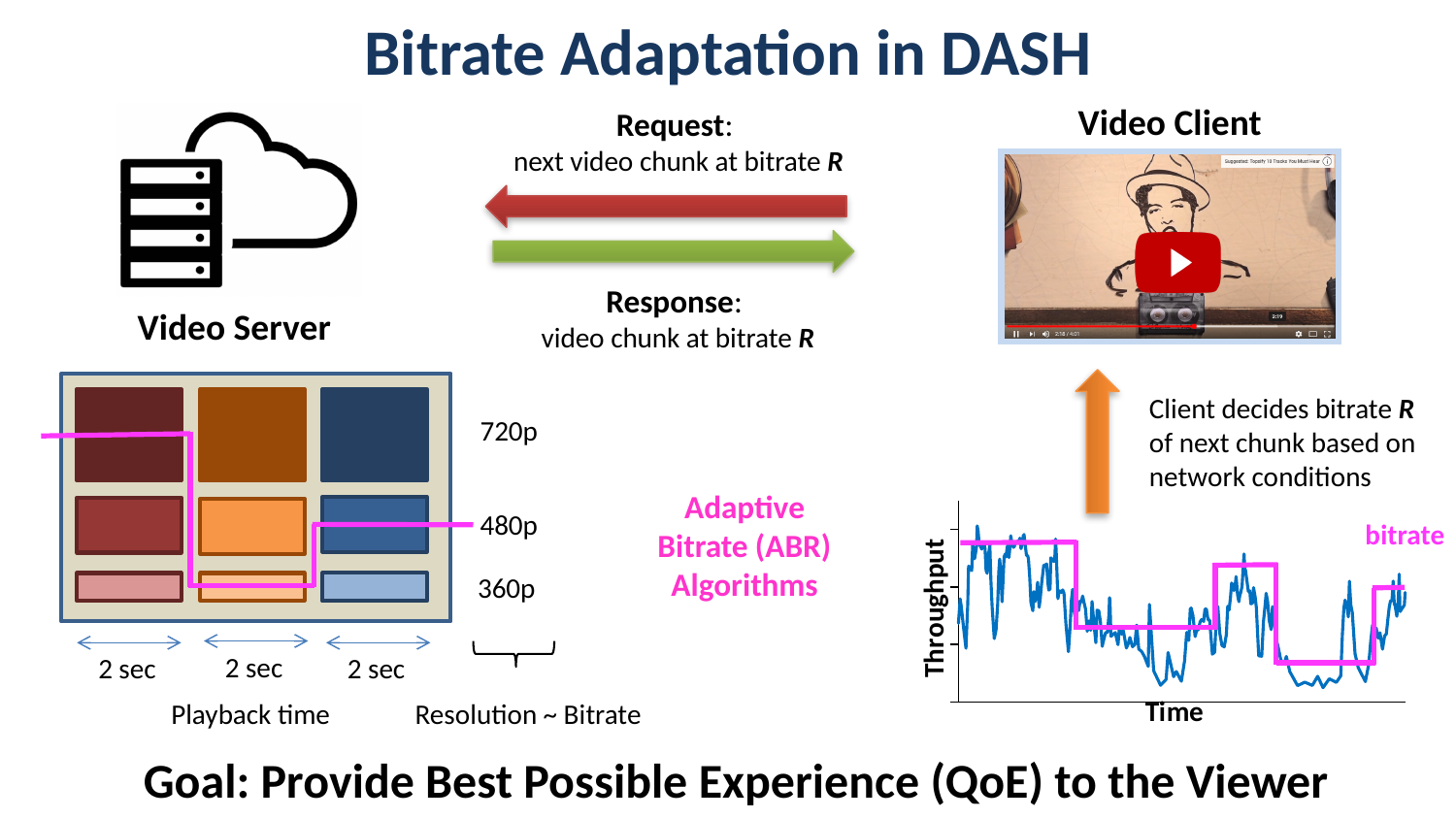
In the video chunk diagram on the left, what resolution does the magenta line select for the third chunk? 480p In the video chunk diagram on the left, how many resolution levels are labelled? 3 On the Throughput chart, what does the magenta step line represent? bitrate On the Throughput chart, what is the label of the x axis? Time What kind of chart is the Throughput vs Time chart on the right of the slide? line chart In the video chunk diagram on the left, what resolution does the magenta line select for the first chunk? 720p On the Throughput chart, what is the label of the y axis? Throughput In the video chunk diagram on the left, how many chunks are shown along the playback time axis? 3 In the video chunk diagram on the left, what is the highest resolution labelled? 720p In the video chunk diagram on the left, how long is each video chunk in playback time? 2 sec In the video chunk diagram on the left, what is the lowest resolution labelled? 360p